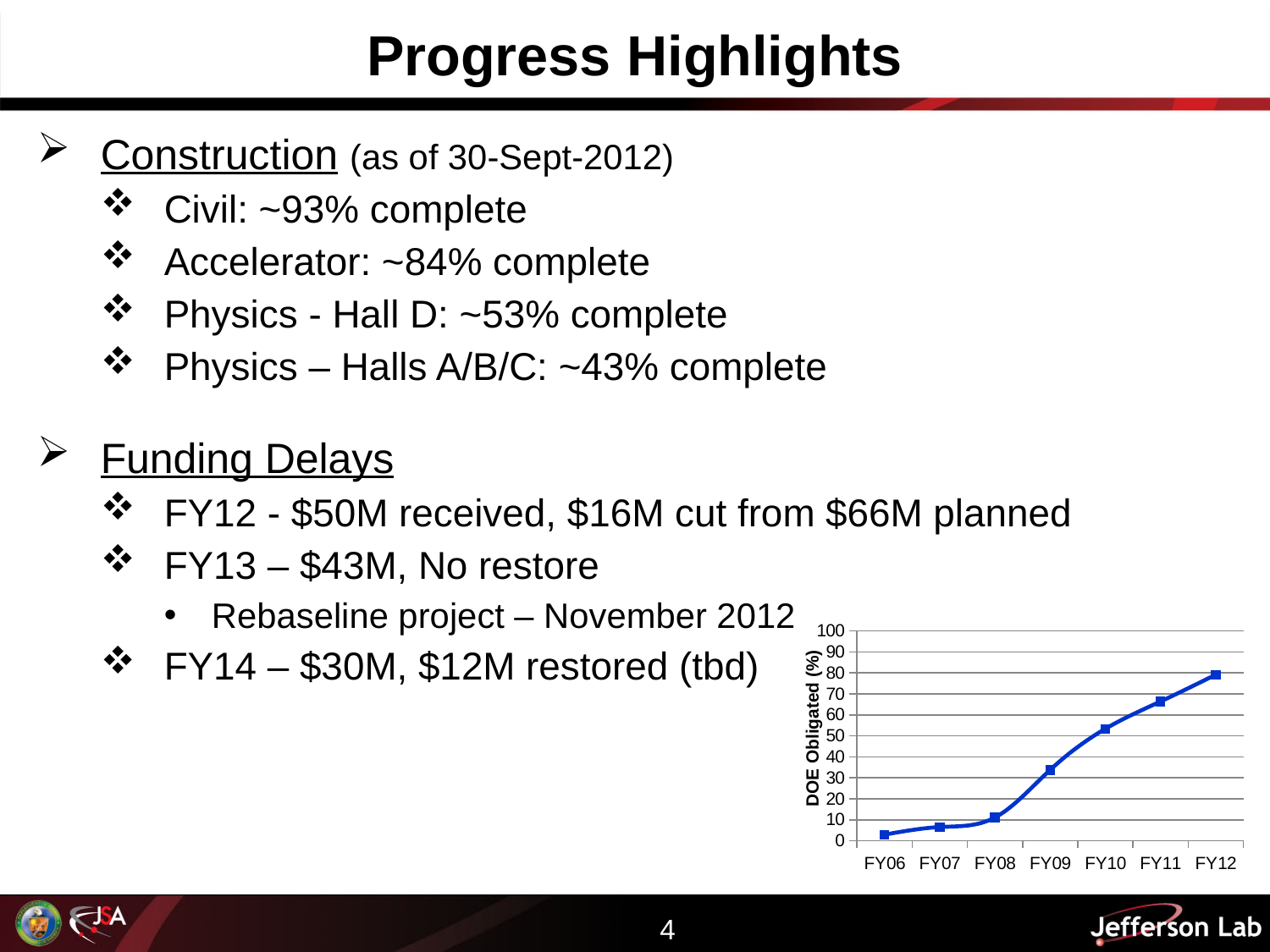
Which fiscal year has the lowest DOE Obligated (%) value in the chart? FY06 Is the value for FY08 greater or less than 20? less Is the value for FY10 greater or less than 40? greater Is the value for FY06 greater or less than 10? less Which fiscal year has the highest DOE Obligated (%) value in the chart? FY12 How many fiscal years are plotted on the x axis of the chart? 7 Which is larger, the value for FY09 or the value for FY11? FY11 What is the maximum value shown on the y axis of the chart? 100 What is the label on the y axis of the chart? DOE Obligated (%) What kind of chart is shown on the slide? line chart Do the values in the chart rise or fall from FY06 to FY12? rise